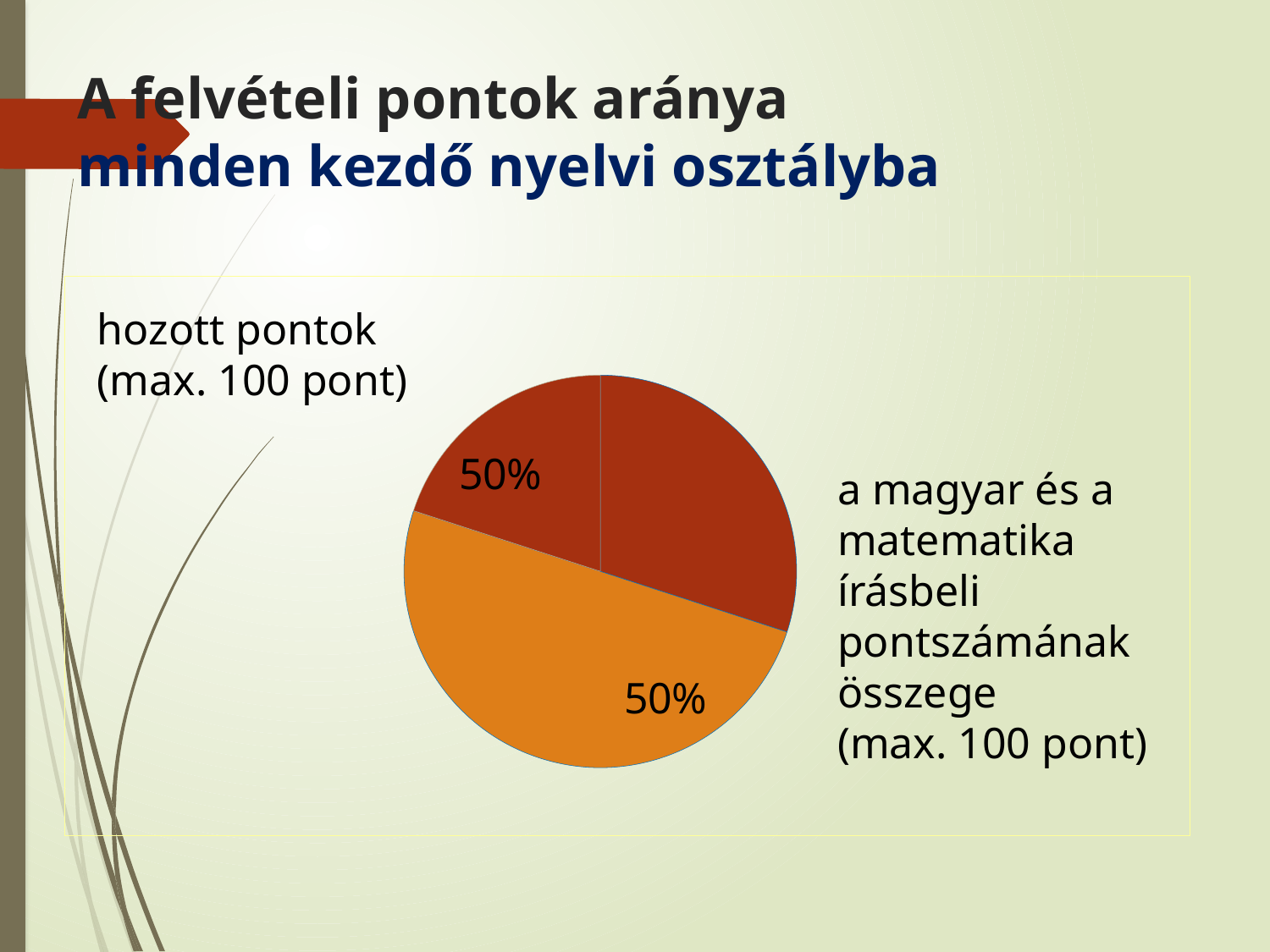
What is the maximum number of points stated for the sum of the Hungarian and mathematics written scores? 100 pont What is the title of the slide containing the pie chart? A felvételi pontok aránya minden kezdő nyelvi osztályba What colour is the slice labelled 'hozott pontok'? Dark red What is the maximum number of points stated for 'hozott pontok'? 100 pont What kind of chart is shown on the slide? Pie chart What is the difference between the two percentages shown on the pie chart? 0% What share of the pie is labelled for 'a magyar és a matematika írásbeli pontszámának összege'? 50% Is the share for 'hozott pontok' larger, smaller or equal to the share for the written Hungarian and mathematics points? Equal What do the two slice percentages on the pie chart add up to? 100% What share of the pie is labelled for 'hozott pontok'? 50% How many slices does the pie chart have? 2